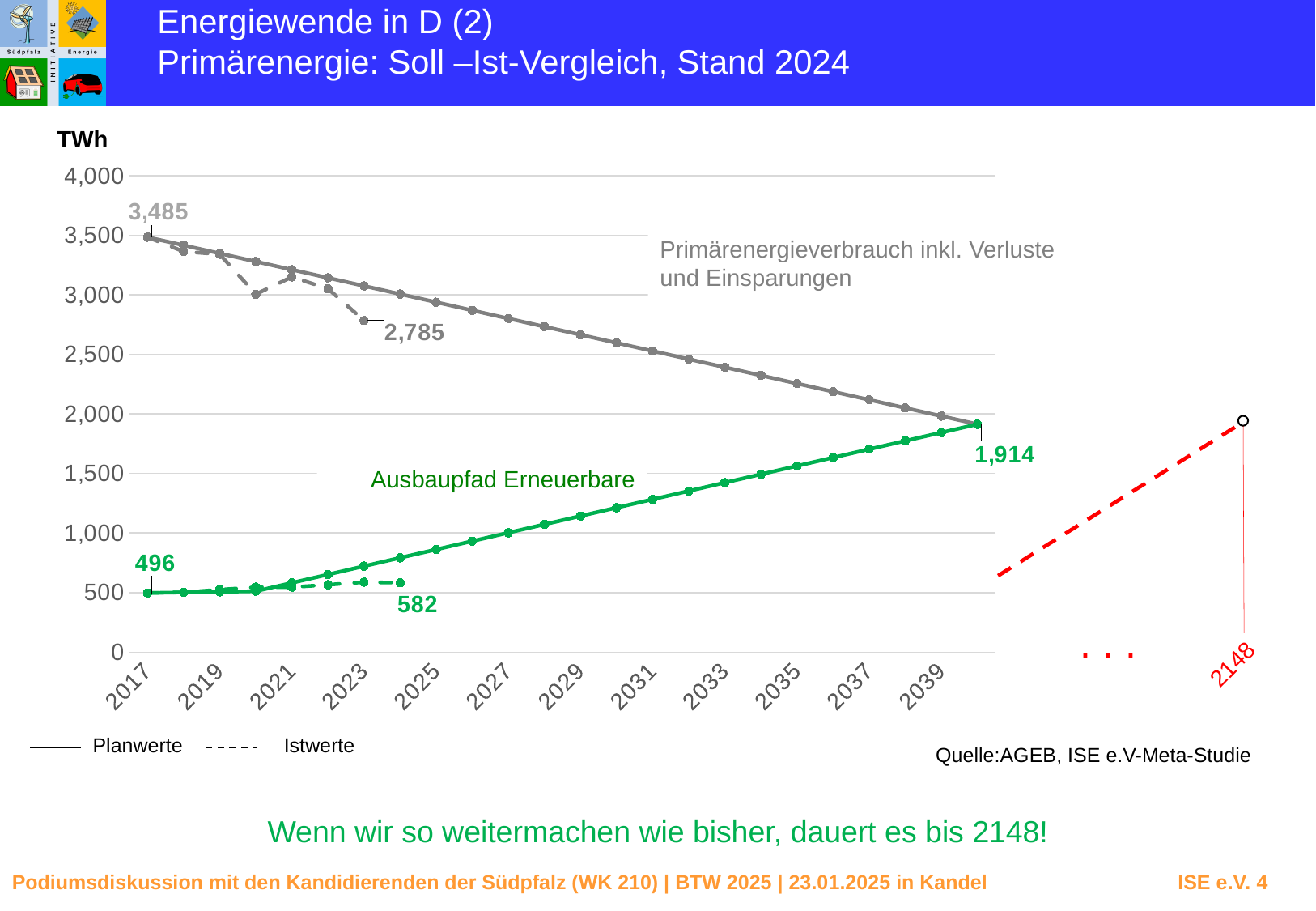
What kind of chart is shown on the slide? line chart What is the value of Primärenergieverbrauch in 2017? 3,485 What is the labelled Istwert for Primärenergieverbrauch in 2023? 2,785 Does the Primärenergieverbrauch plan line rise or fall from 2017 to 2039? fall Is the Primärenergieverbrauch plan value for 2029 greater or less than 3,000? less By how much did the Primärenergieverbrauch fall from the 2017 value of 3,485 to the 2023 Istwert of 2,785? 700 According to the legend, what does the dashed line style represent? Istwerte What value does the Ausbaupfad Erneuerbare plan line reach at its end point? 1,914 Which is larger in 2017: Primärenergieverbrauch or Ausbaupfad Erneuerbare? Primärenergieverbrauch What is the value of the Ausbaupfad Erneuerbare in 2017? 496